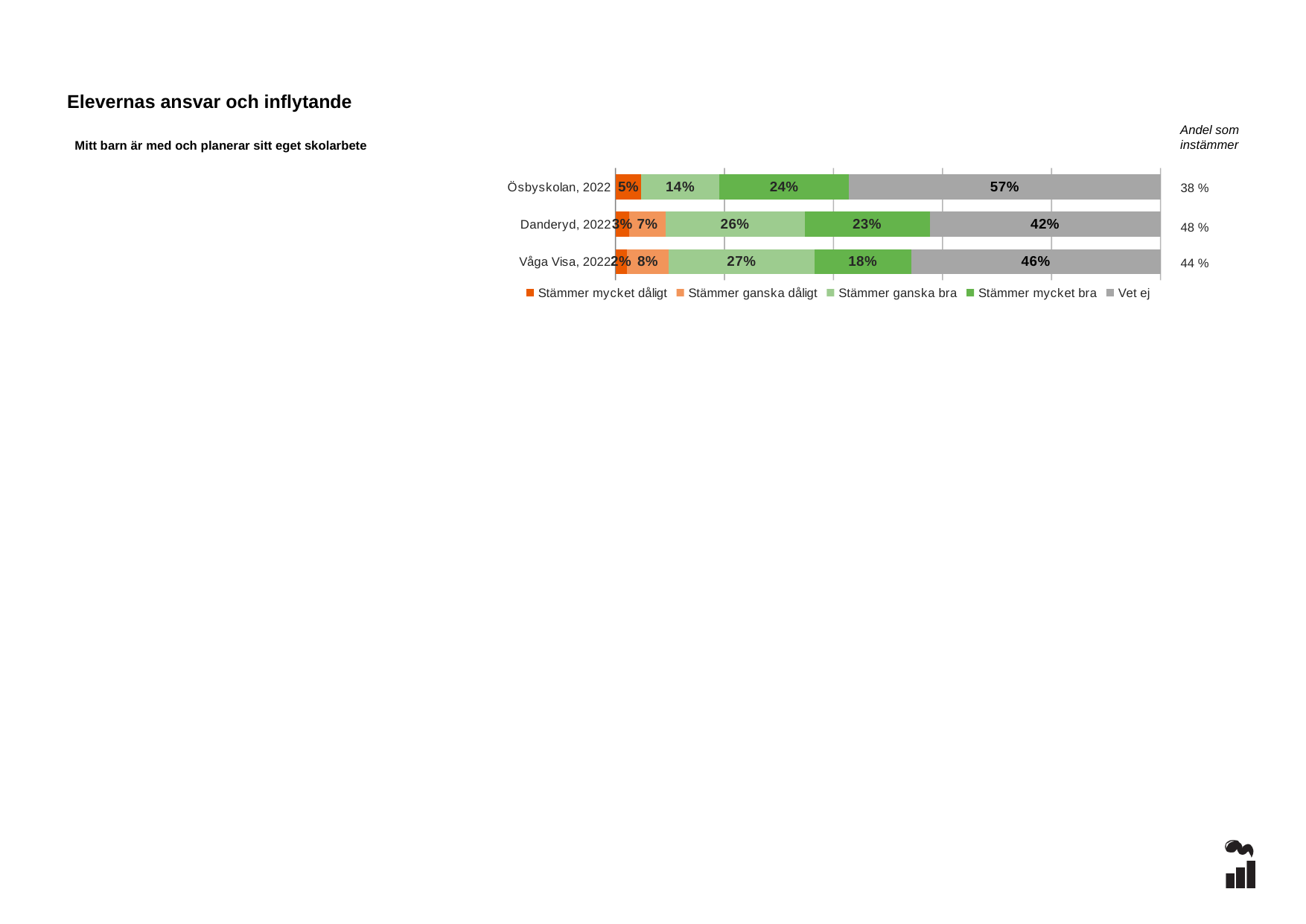
What is the "Stämmer ganska bra" value for Danderyd, 2022? 26% Which has the larger "Stämmer ganska dåligt" value, Danderyd, 2022 or Våga Visa, 2022? Våga Visa, 2022 How many categories (bars) does the chart show? 3 Which category has the highest "Vet ej" value? Ösbyskolan, 2022 How many series does the legend list? 5 What is the "Stämmer mycket bra" value for Våga Visa, 2022? 18% Which category has the lowest "Stämmer mycket bra" value? Våga Visa, 2022 What statement is the chart about, as shown in the subtitle above the chart? Mitt barn är med och planerar sitt eget skolarbete What is the "Andel som instämmer" value shown for Danderyd, 2022? 48 % What kind of chart is shown on the slide? Stacked bar chart What is the difference between the "Vet ej" values for Ösbyskolan, 2022 and Våga Visa, 2022? 11 percentage points What is the "Vet ej" value for Ösbyskolan, 2022? 57%